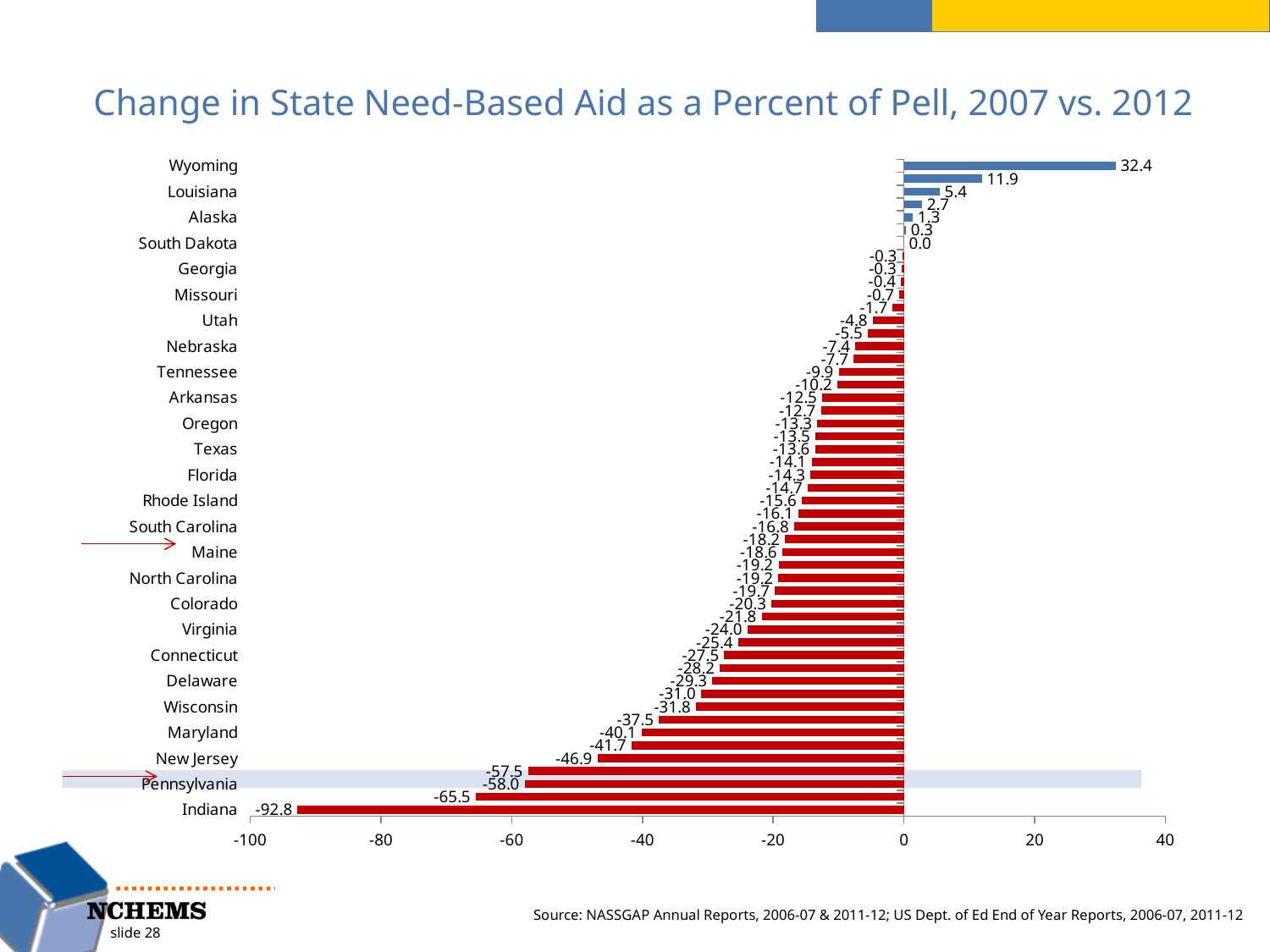
What is the value shown for Indiana? -92.8 Which state has the lowest change in state need-based aid as a percent of Pell? Indiana What kind of chart is shown on the slide? bar chart What is the difference between the values for Wyoming and Indiana? 125.2 What is the value shown for South Dakota? 0.0 What is the title of the chart? Change in State Need-Based Aid as a Percent of Pell, 2007 vs. 2012 What is the value shown for Pennsylvania? -58.0 What is the value shown for Wyoming? 32.4 Is the value for New Jersey greater or less than -40? less Which has the larger value, Wyoming or Louisiana? Wyoming What is the value shown for Louisiana? 5.4 Which state has the highest change in state need-based aid as a percent of Pell? Wyoming